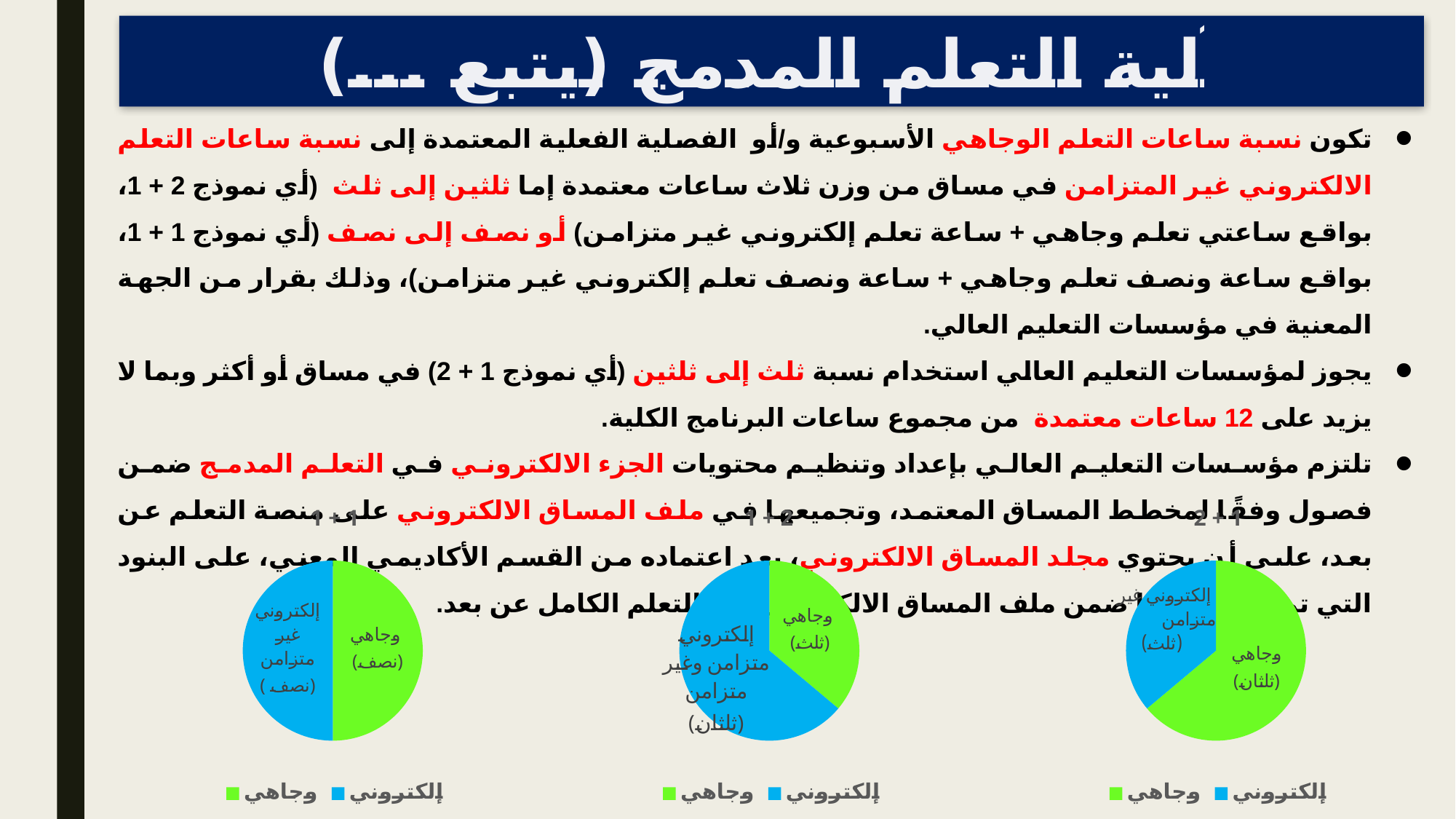
In the middle pie chart, what share is labelled for the وجاهي slice? ثلث What colour represents وجاهي in the legends of the pie charts? green In the left pie chart, what share is labelled for the وجاهي slice? نصف In the right pie chart, what share is labelled for the وجاهي slice? ثلثان In the right pie chart, which slice is the largest? وجاهي How many series does the legend of the right pie chart list? 2 What kind of chart is the left chart on the slide? pie chart How many slices does the middle pie chart have? 2 How many charts are shown on the slide? 3 In the middle pie chart, which slice is larger, وجاهي or إلكتروني? إلكتروني